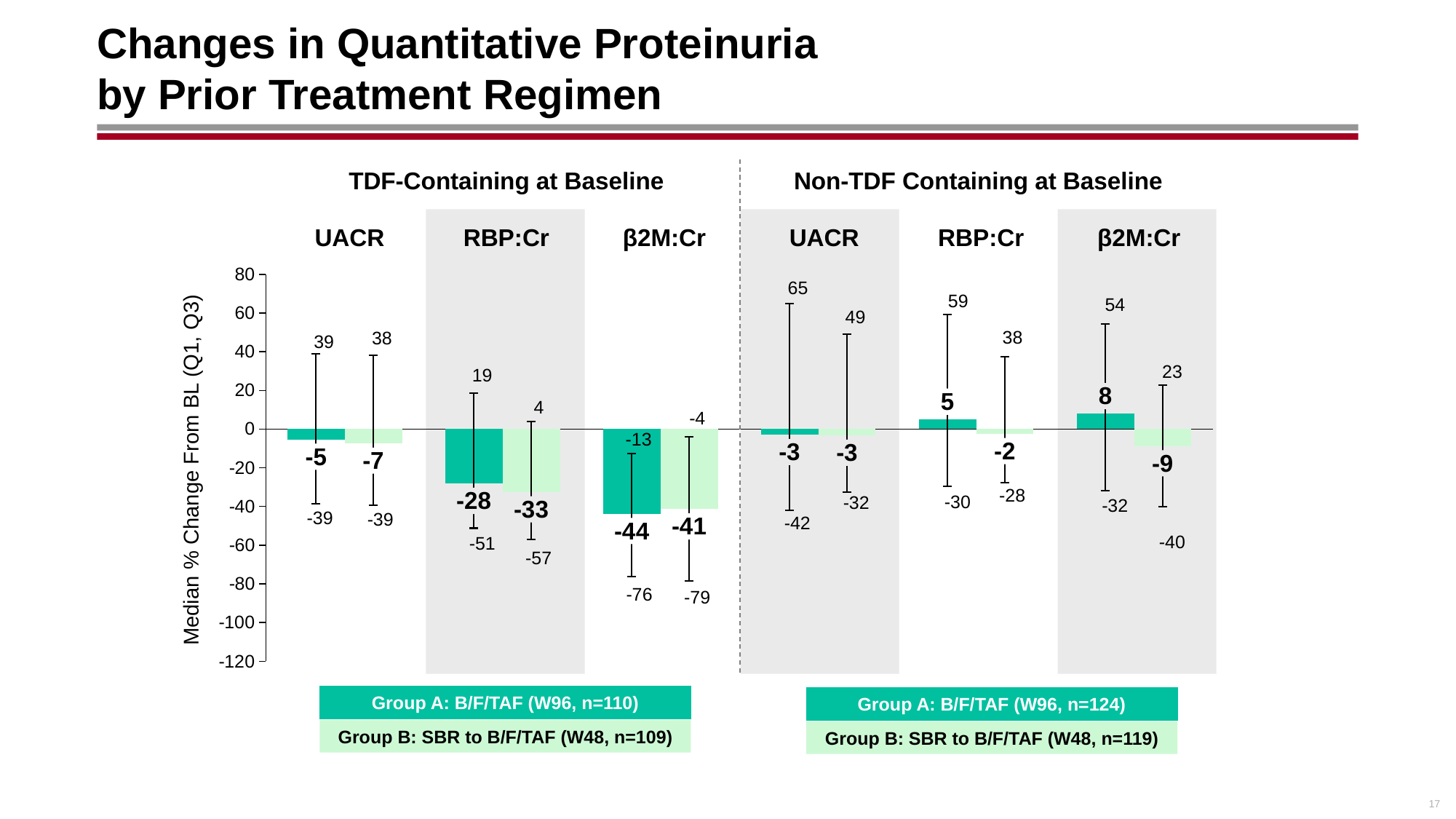
How many groups (series) are shown in the legend for each panel? 2 What is the median % change from baseline in UACR for Group A in the TDF-Containing at Baseline panel? -5 In the TDF-Containing at Baseline panel, which marker shows the largest median decrease for Group A? β2M:Cr What is the median % change from baseline in RBP:Cr for Group A in the Non-TDF Containing at Baseline panel? 5 In the Non-TDF Containing at Baseline panel, which marker has the highest median % change for Group A? β2M:Cr What is the median % change from baseline in β2M:Cr for Group B in the Non-TDF Containing at Baseline panel? -9 In the TDF-Containing at Baseline panel, is the Group A median % change in RBP:Cr greater or less than -20? less What is the median % change from baseline in β2M:Cr for Group B in the TDF-Containing at Baseline panel? -41 What is the Q1 value shown for Group B β2M:Cr in the TDF-Containing at Baseline panel? -79 What is the difference between the Group A and Group B median % change in RBP:Cr in the TDF-Containing at Baseline panel? 5 What is the Q3 value shown for Group A UACR in the Non-TDF Containing at Baseline panel? 65 What type of chart is shown on the slide? Bar chart